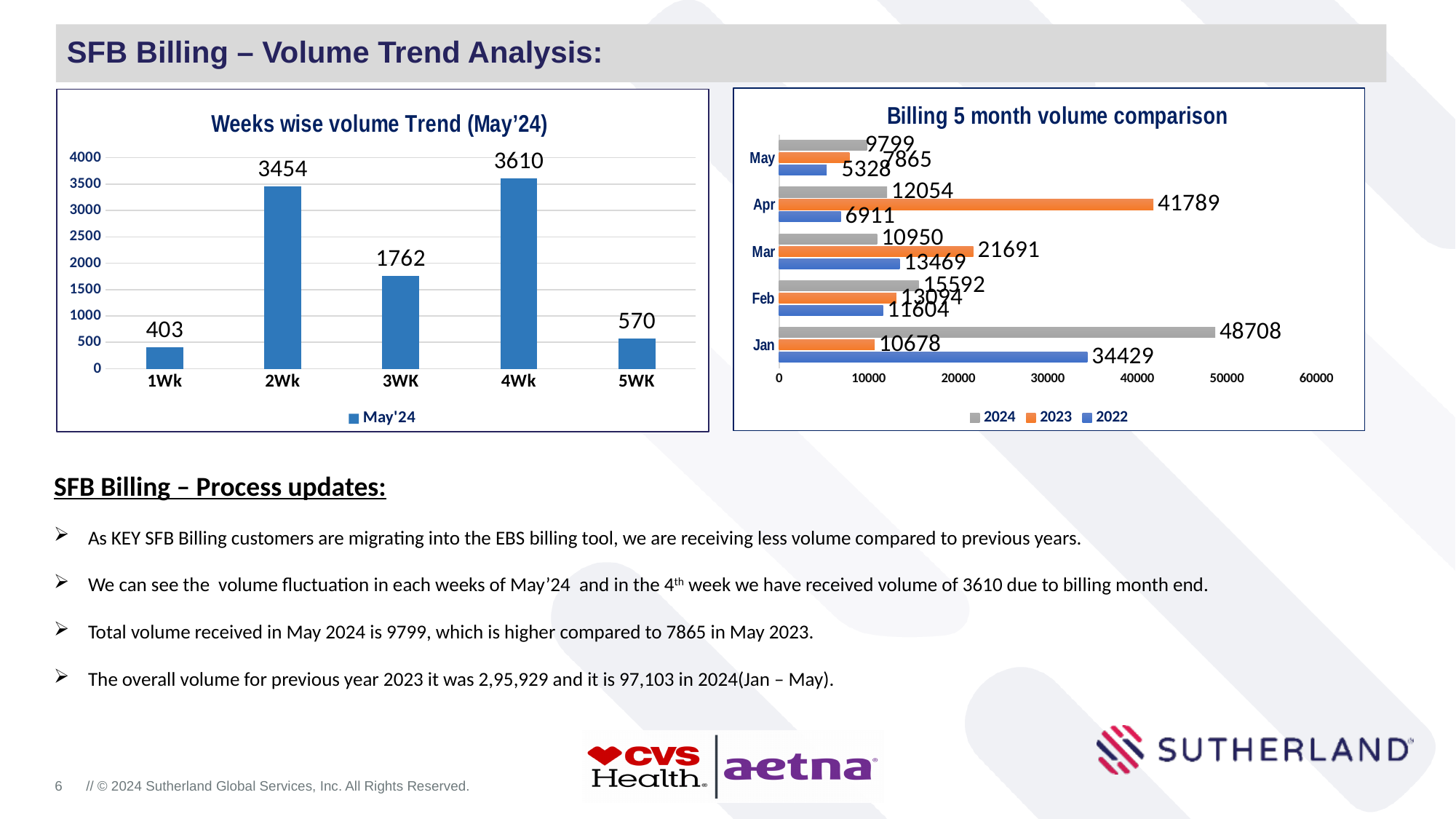
In the 'Weeks wise volume Trend (May'24)' chart, what is the difference between the values for 4Wk and 3WK? 1848 In the 'Weeks wise volume Trend (May'24)' chart, which week has the lowest volume? 1Wk In the 'Weeks wise volume Trend (May'24)' chart, how many weeks are plotted? 5 In the 'Weeks wise volume Trend (May'24)' chart, what is the value for 2Wk? 3454 In the 'Billing 5 month volume comparison' chart, what is the value for 2023 in Apr? 41789 In the 'Billing 5 month volume comparison' chart, which is larger in May: the 2024 value or the 2023 value? 2024 In the 'Weeks wise volume Trend (May'24)' chart, which week has the highest volume? 4Wk What kind of chart is the 'Weeks wise volume Trend (May'24)' chart? Bar chart In the 'Billing 5 month volume comparison' chart, what is the value for 2022 in Jan? 34429 In the 'Billing 5 month volume comparison' chart, which month has the highest value for 2024? Jan How many series does the legend of the 'Billing 5 month volume comparison' chart list? 3 In the 'Billing 5 month volume comparison' chart, what is the difference between the 2024 and 2023 values for May? 1934